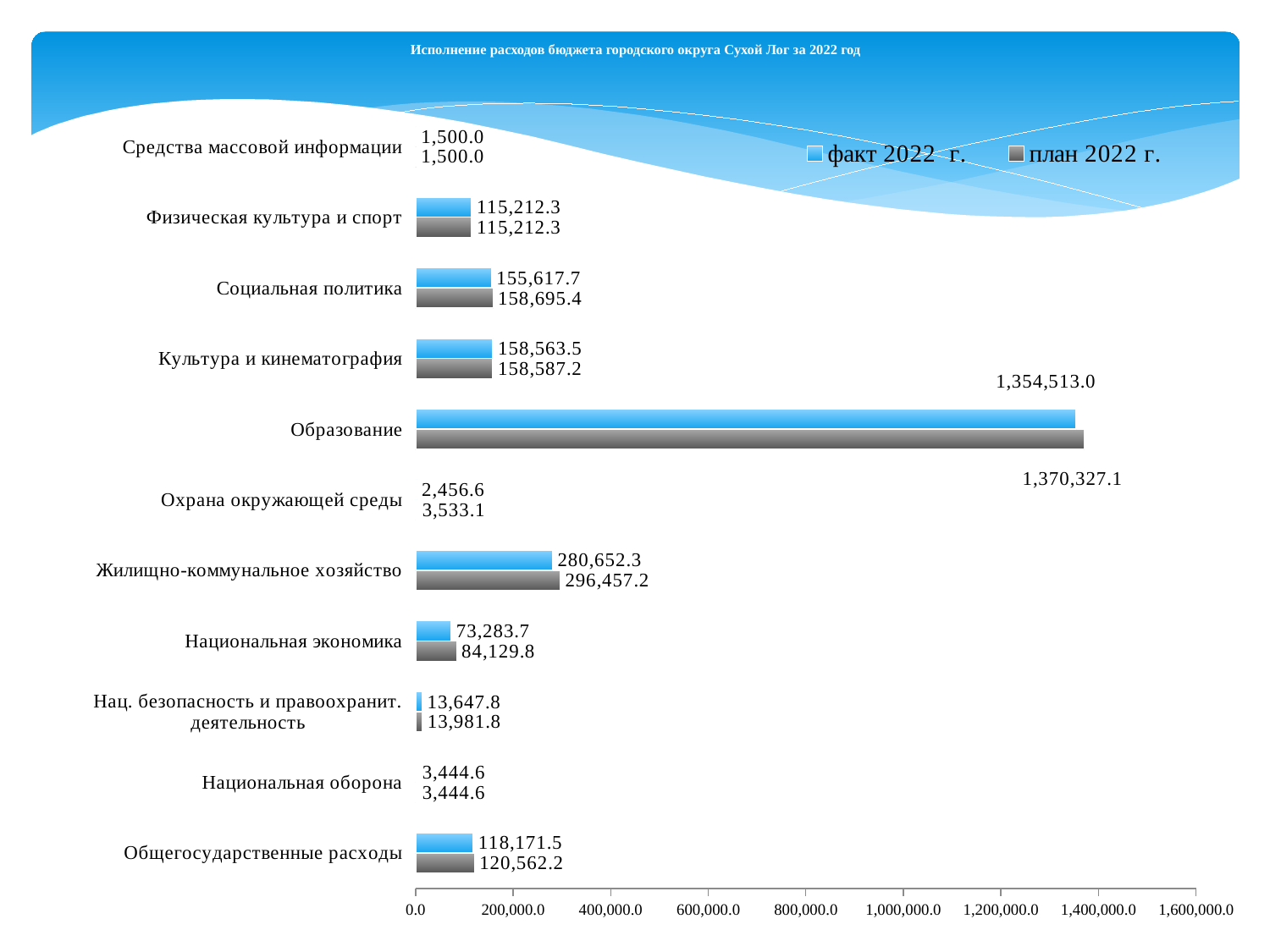
What is the difference between the план 2022 г. and факт 2022 г. values for Образование? 15,814.1 What is the difference between the план 2022 г. and факт 2022 г. values for Национальная экономика? 10,846.1 How many categories are shown on the chart? 11 What is the план 2022 г. value for Жилищно-коммунальное хозяйство? 296,457.2 What is the факт 2022 г. value for Национальная экономика? 73,283.7 What type of chart is shown on the slide? bar chart What is the title of the chart? Исполнение расходов бюджета городского округа Сухой Лог за 2022 год How many series does the legend list? 2 Which is larger for Охрана окружающей среды: the факт 2022 г. value or the план 2022 г. value? план 2022 г. Which category has the highest план 2022 г. value? Образование What is the факт 2022 г. value for Образование? 1,354,513.0 Which category has the lowest факт 2022 г. value? Средства массовой информации